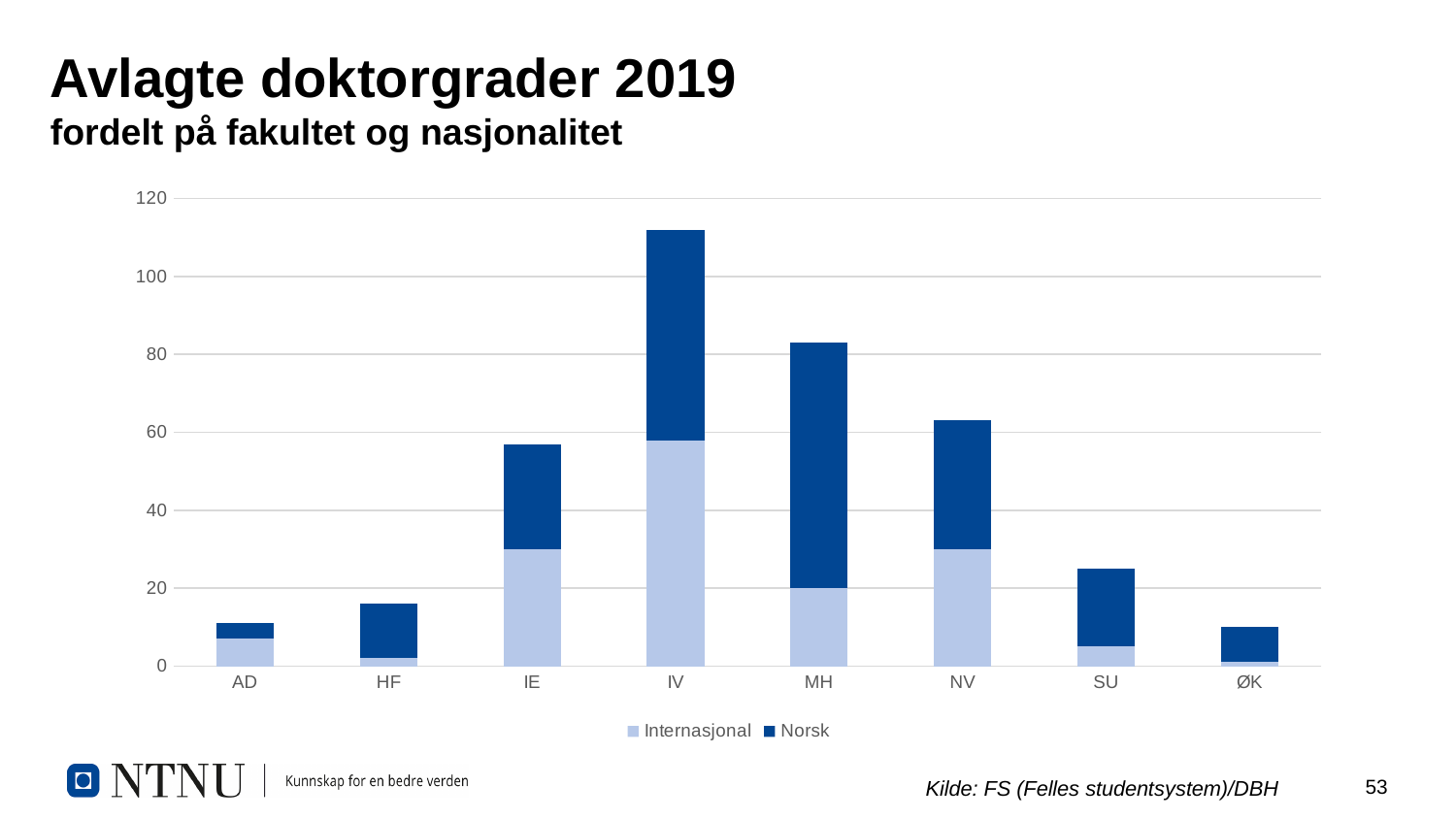
Is the total value for ØK greater or less than 20? less Which faculty has the highest total number of doctoral degrees? IV What kind of chart is shown on the slide? Stacked bar chart Which faculty has the larger total bar, IV or MH? IV Which faculty has the larger total bar, MH or NV? MH Is the total value for IV greater or less than 100? greater How many faculties (categories) are shown on the x axis? 8 How many series does the legend list? 2 What are the two series named in the legend? Internasjonal and Norsk Is the total value for IE greater or less than 40? greater What is the title of the chart on the slide? Avlagte doktorgrader 2019